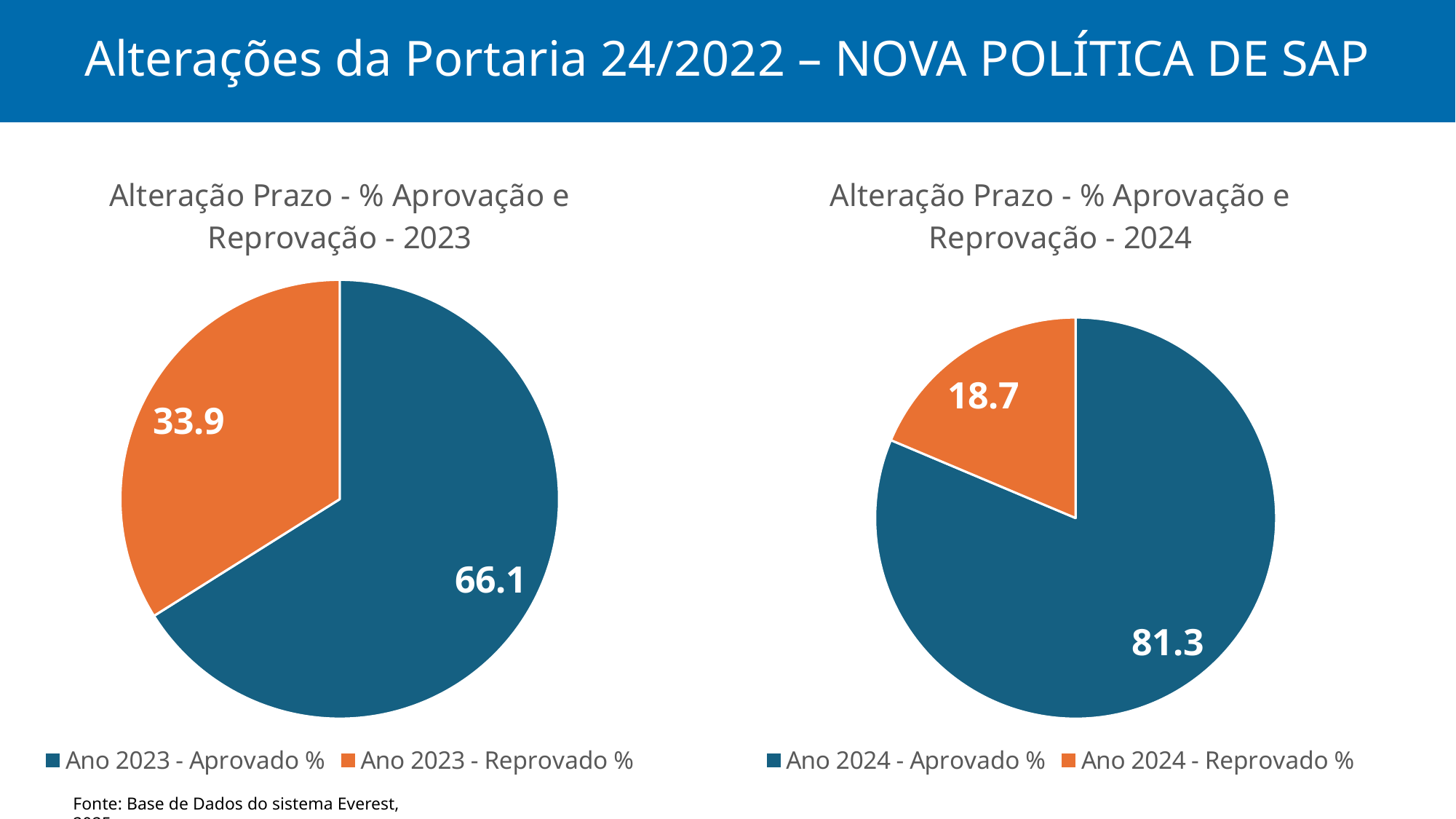
In the 2023 chart (left), what is the value for Ano 2023 - Reprovado %? 33.9 In the 2023 chart (left), which slice is the largest? Ano 2023 - Aprovado % In the 2024 chart (right), what is the value for Ano 2024 - Reprovado %? 18.7 Which is larger: the Reprovado value in the 2023 chart or the Reprovado value in the 2024 chart? 2023 chart (33.9) What kind of chart is the chart on the left? Pie chart In the 2023 chart (left), what is the difference between the Aprovado and Reprovado values? 32.2 In the 2024 chart (right), what is the difference between the Aprovado and Reprovado values? 62.6 How many entries does the legend of the 2023 chart (left) list? 2 How many slices does the 2024 chart (right) have? 2 In the 2023 chart (left), what is the value for Ano 2023 - Aprovado %? 66.1 In the 2024 chart (right), what is the value for Ano 2024 - Aprovado %? 81.3 In the 2024 chart (right), which slice is the smallest? Ano 2024 - Reprovado %